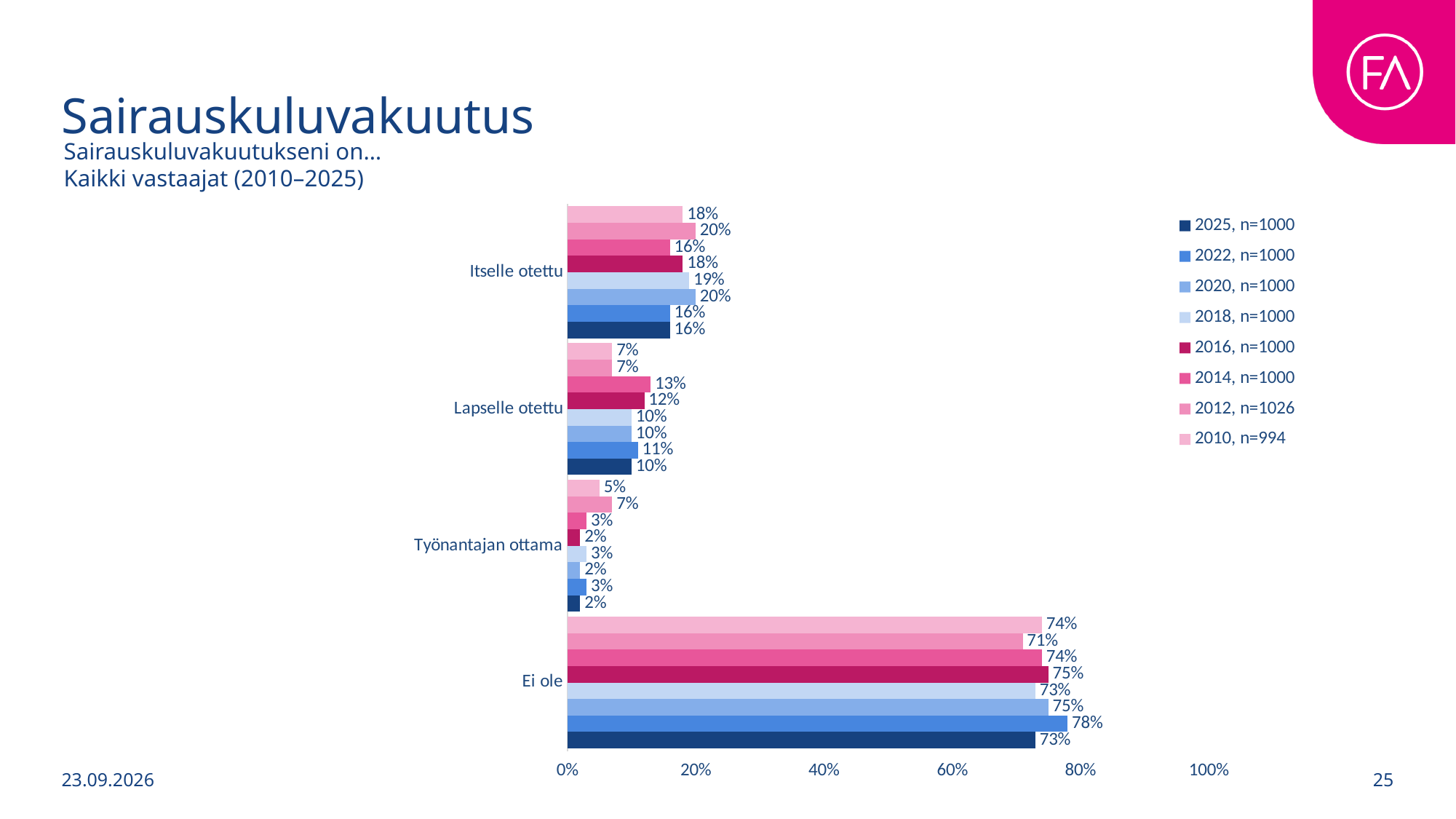
Which category has the highest value in the 2025 series? Ei ole Which is larger for 'Itselle otettu': the 2020 value or the 2025 value? 2020 What is the value for 'Lapselle otettu' in the 2014 series? 13% How many series does the legend list? 8 What sample size is listed in the legend for 2010? n=994 What is the value for 'Ei ole' in the 2022 series? 78% What is the value for 'Ei ole' in the 2025 series? 73% What kind of chart is shown on the slide? bar chart What is the difference between the 2022 and 2025 values for 'Ei ole'? 5% What is the value for 'Työnantajan ottama' in the 2012 series? 7% How many categories are shown on the chart? 4 Which category has the lowest value in the 2016 series? Työnantajan ottama